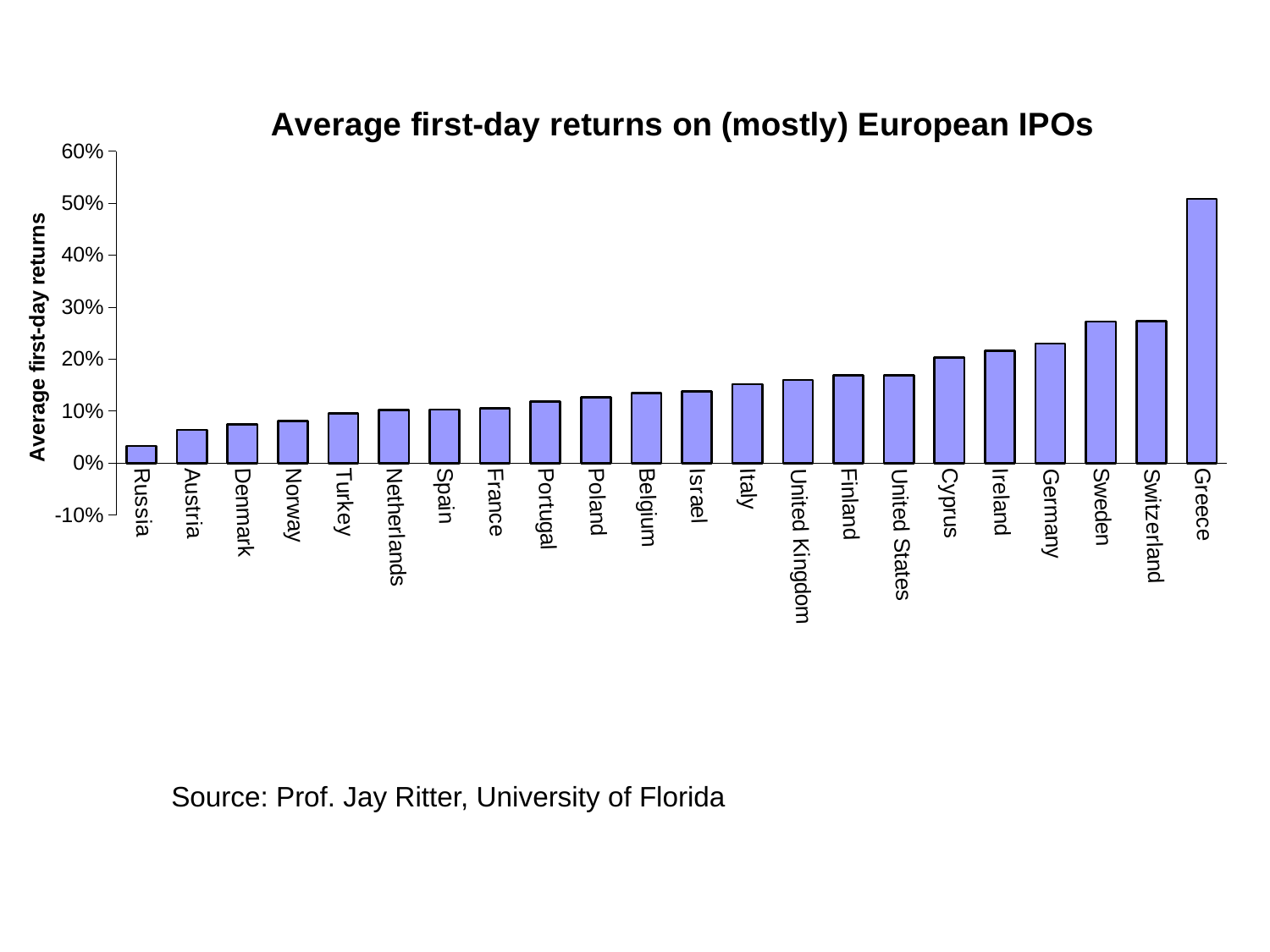
What kind of chart is shown on the slide? bar chart Which country has the lowest average first-day return? Russia Which country has the highest average first-day return? Greece How many countries are shown on the chart? 22 Which has a higher average first-day return, Spain or Italy? Italy Is the value for Italy greater or less than 10%? greater Is the value for Switzerland greater or less than 30%? less Is the value for Germany greater or less than 20%? greater Do the values generally rise or fall moving from left to right along the x axis? rise Which has a higher average first-day return, Greece or Switzerland? Greece